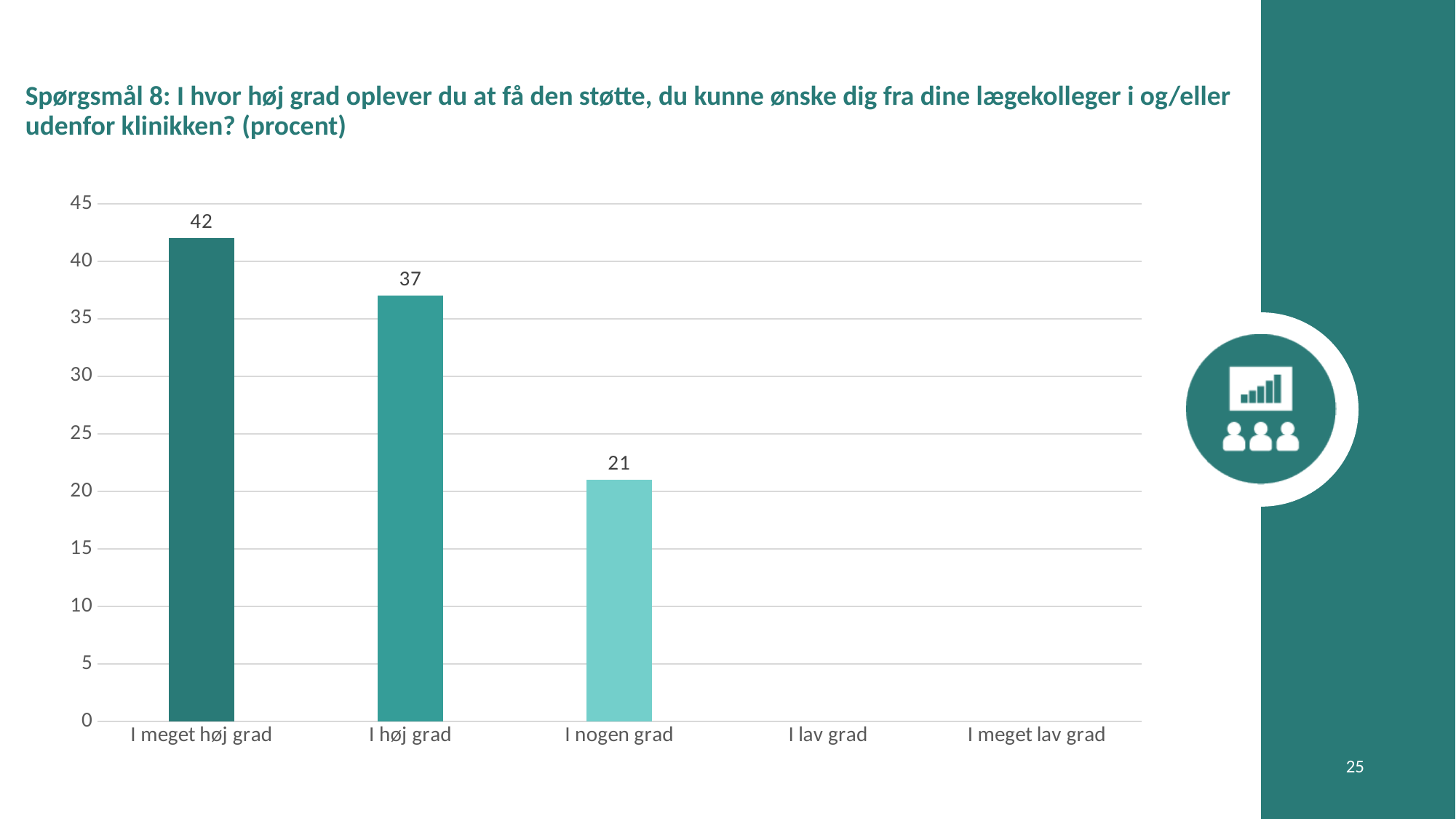
What is the value for "I høj grad"? 37 What is the difference between the values for "I høj grad" and "I nogen grad"? 16 What is the difference between the values for "I meget høj grad" and "I høj grad"? 5 What kind of chart is shown on the slide? bar chart Is the value for "I meget høj grad" greater or less than 40? greater Which is larger, the value for "I høj grad" or the value for "I nogen grad"? I høj grad Do the values rise or fall from "I meget høj grad" to "I nogen grad"? fall What is the highest value shown on the y axis? 45 How many categories are shown on the x axis? 5 Which category has the highest value? I meget høj grad What is the value for "I nogen grad"? 21 What is the value for "I meget høj grad"? 42